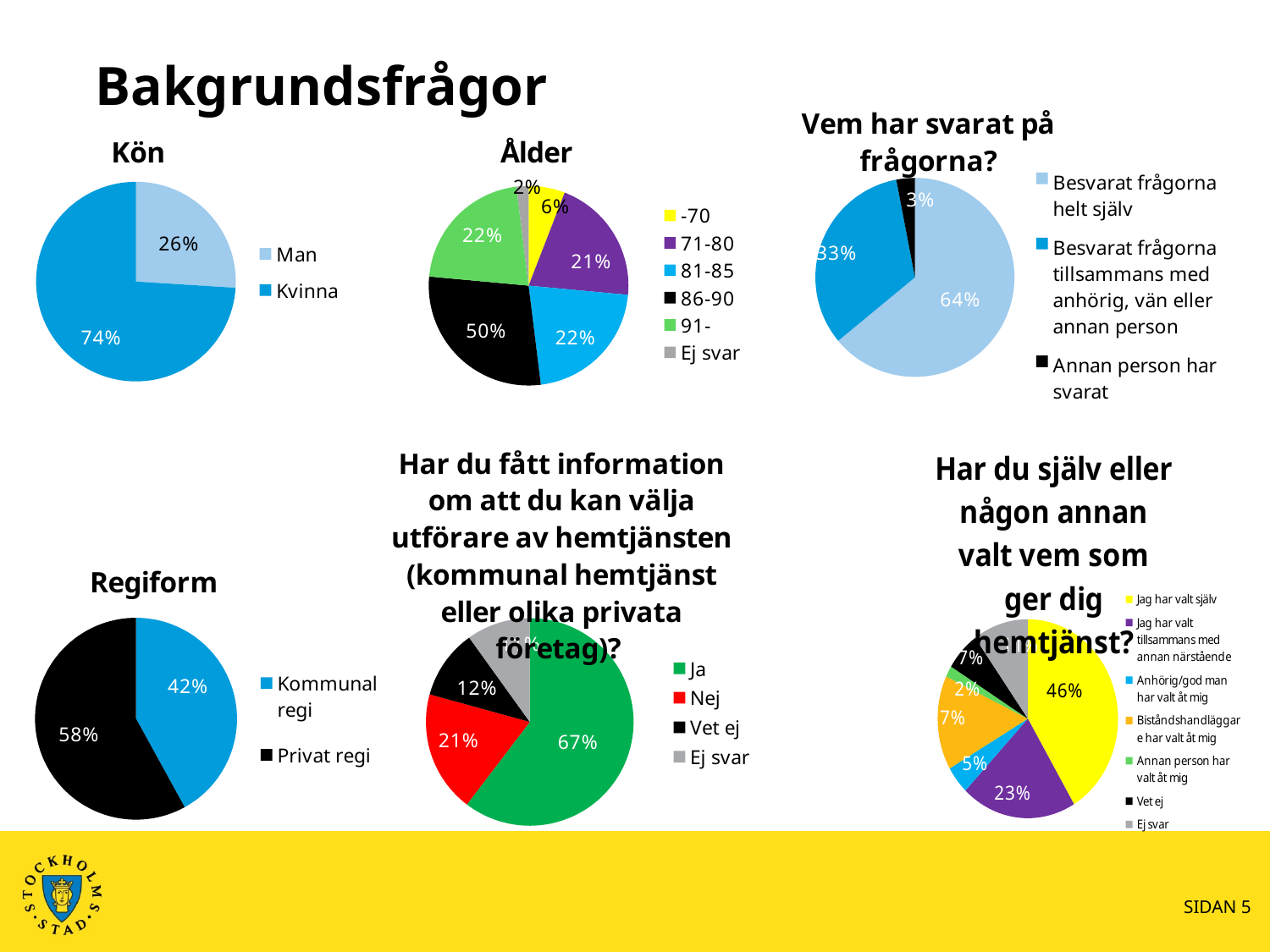
In the 'Ålder' chart, what percentage is the 86-90 age group? 50% In the 'Ålder' chart, what percentage is the -70 age group? 6% In the 'Regiform' chart, which is larger, Kommunal regi or Privat regi? Privat regi In the 'Har du själv eller någon annan valt vem som ger dig hemtjänst?' chart, what percentage is 'Jag har valt själv'? 46% In the 'Har du fått information om att du kan välja utförare av hemtjänsten' chart, what percentage answered Nej? 21% In the 'Kön' chart, what percentage is Man? 26% In the 'Kön' chart, what percentage is Kvinna? 74% In the 'Ålder' chart, how many categories does the legend list? 6 In the 'Vem har svarat på frågorna?' chart, which category is the smallest? Annan person har svarat In the 'Regiform' chart, what is the difference between Privat regi and Kommunal regi? 16% In the 'Vem har svarat på frågorna?' chart, what percentage answered the questions entirely by themselves (Besvarat frågorna helt själv)? 64% In the 'Har du fått information om att du kan välja utförare av hemtjänsten' chart, what percentage answered Ja? 67%